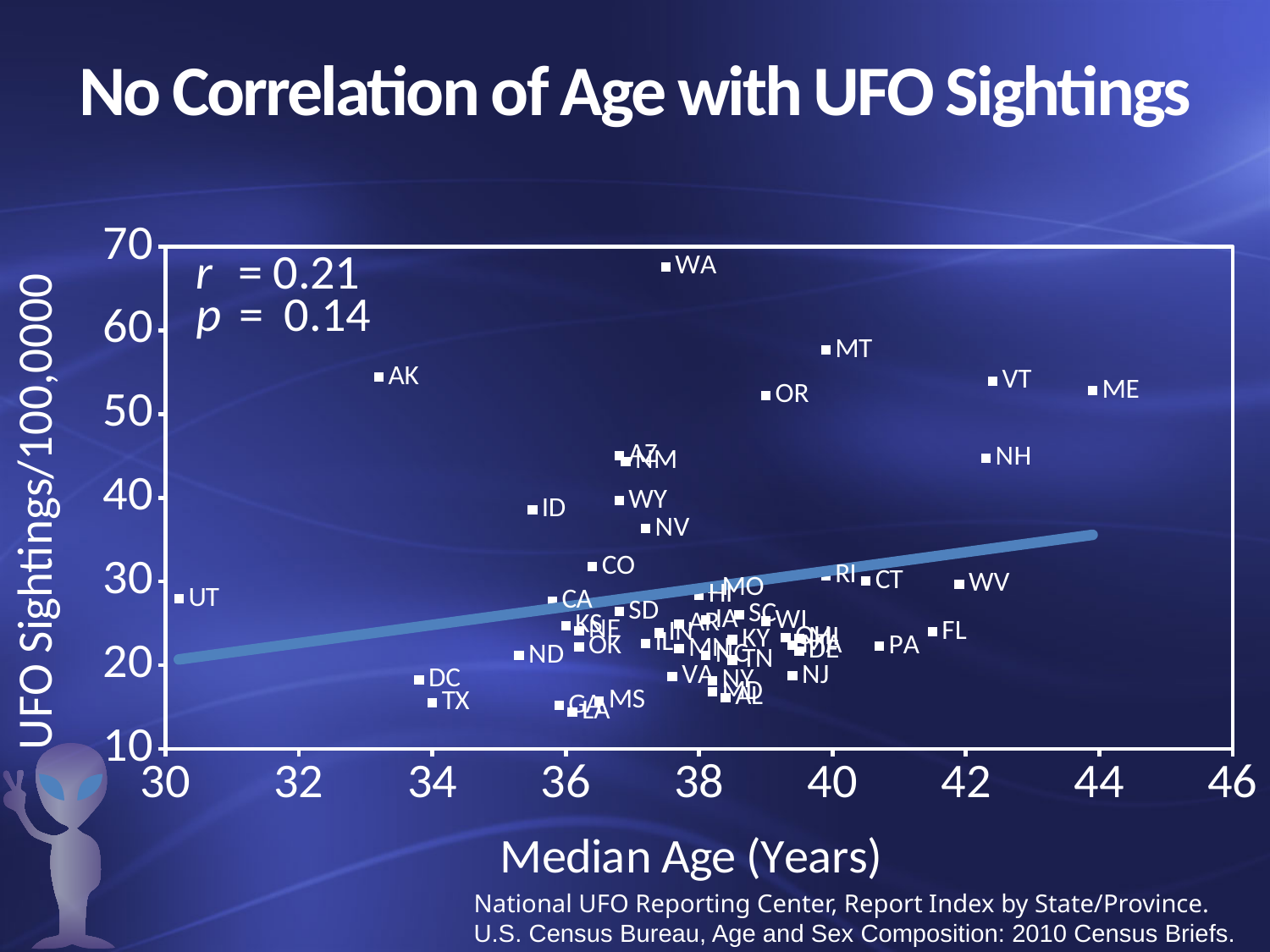
What kind of chart is shown on the slide? scatter plot What is the correlation coefficient r shown on the chart? 0.21 Is the UFO sightings value for ID greater or less than 40? less Which state has more UFO sightings per 100,000, WA or MT? WA Is the UFO sightings value for DC greater or less than 20? less Is the UFO sightings value for WA greater or less than 60? greater Which state has a higher median age, AK or ME? ME What is the p value shown on the chart? 0.14 Which state has the highest UFO sightings per 100,000 on the chart? WA Which state has more UFO sightings per 100,000, NH or WV? NH Which state has the lowest median age on the chart? UT